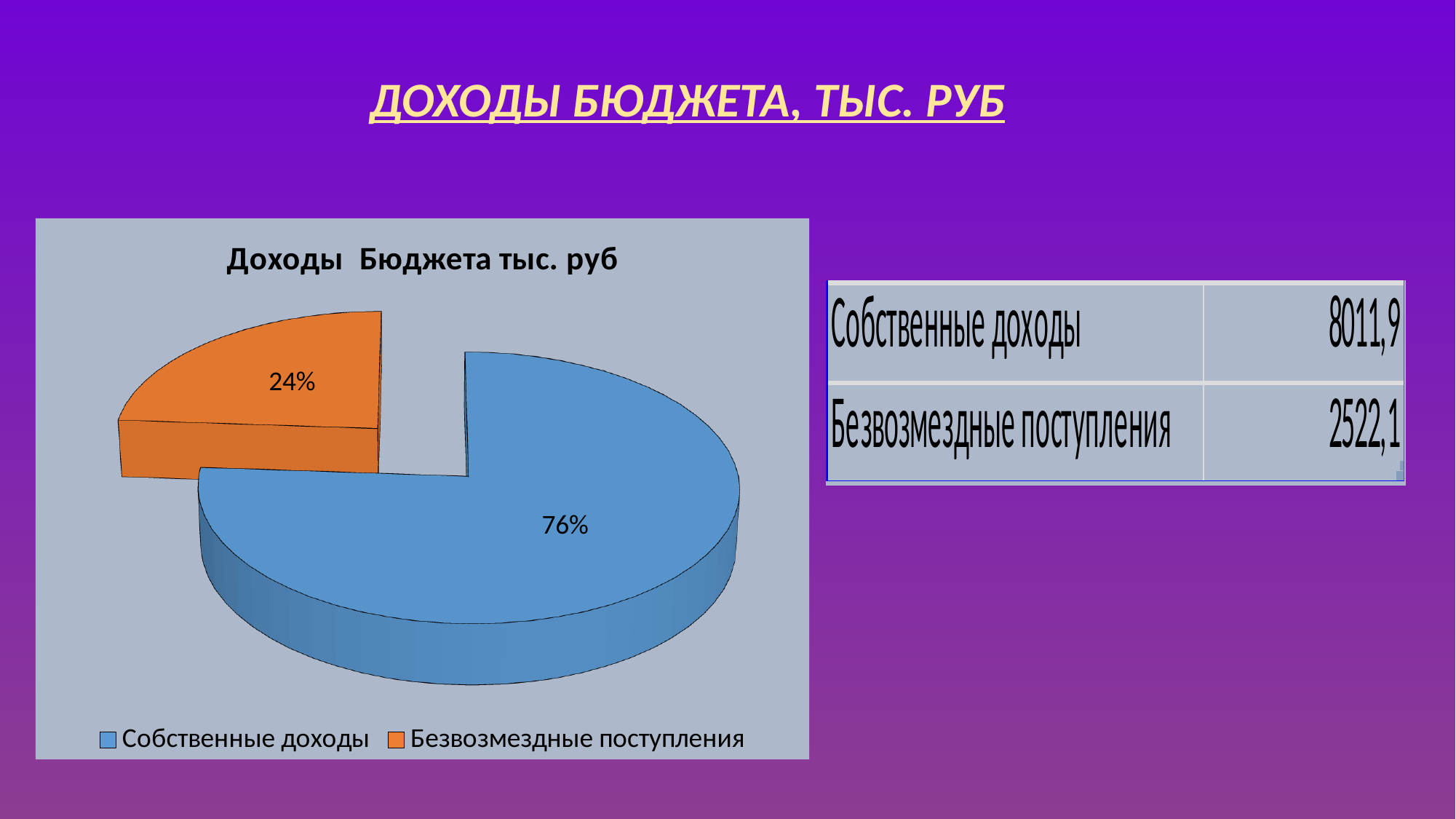
How many entries does the legend list? 2 Which slice of the pie is the smallest? Безвозмездные поступления What is the difference in percentage points between the Собственные доходы slice and the Безвозмездные поступления slice? 52 What colour is the Безвозмездные поступления slice? orange How many slices does the pie chart have? 2 Which is larger, the share for Собственные доходы or the share for Безвозмездные поступления? Собственные доходы What kind of chart is shown on the slide? pie chart What is the title of the chart? Доходы Бюджета тыс. руб What share of the pie does Безвозмездные поступления represent? 24% What share of the pie does Собственные доходы represent? 76% Which slice of the pie is the largest? Собственные доходы